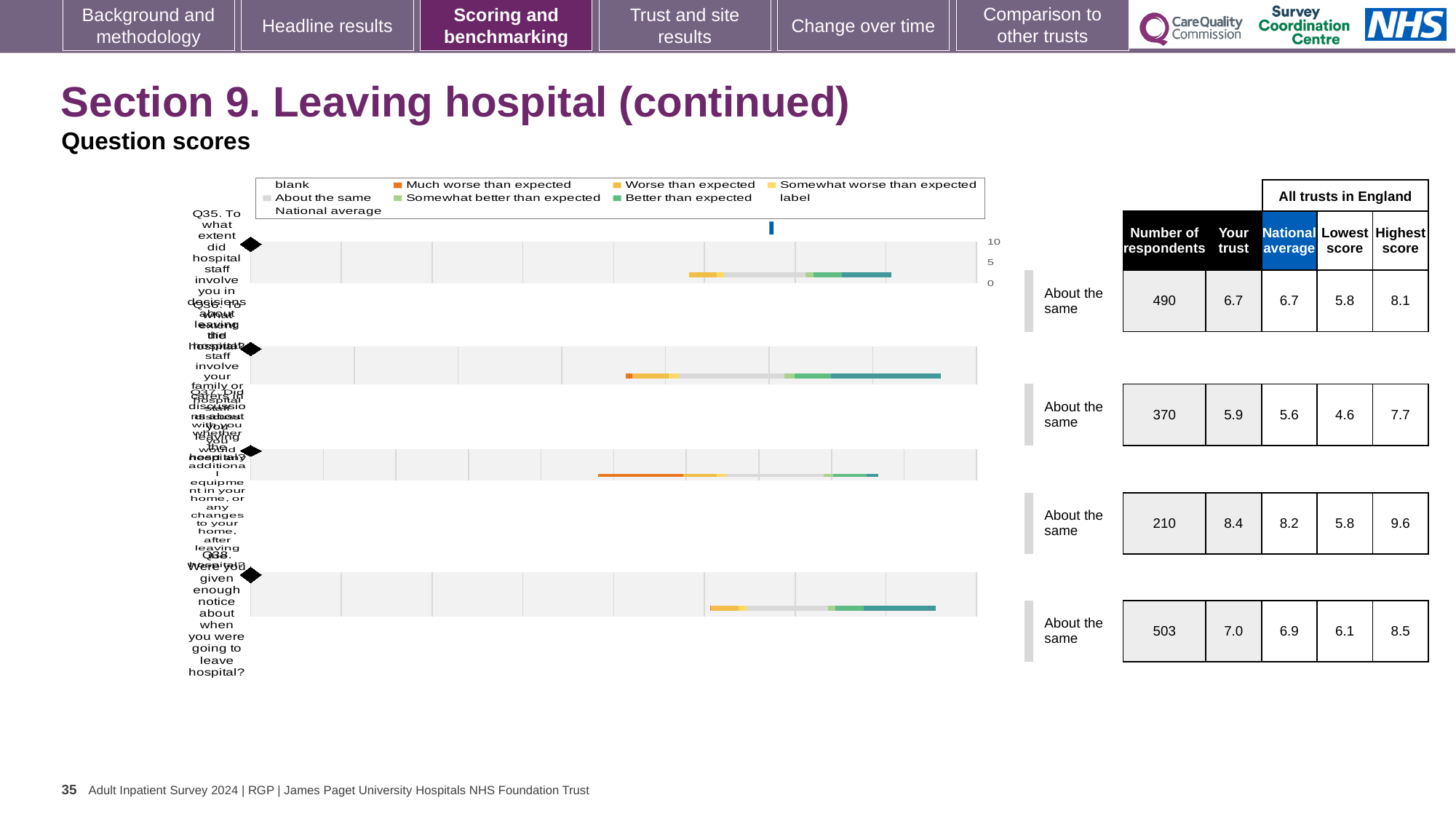
What benchmark category is shown for Q35? About the same What is the 'Your trust' score for Q38 (given enough notice about leaving hospital)? 7.0 What is the 'Your trust' score for Q35 (involving you in decisions about leaving hospital)? 6.7 What type of chart is used to show the question scores? Bar chart What is the highest score across all trusts in England for Q38? 8.5 Which has the higher 'Your trust' score, Q35 or Q38? Q38 What is the lowest score across all trusts in England for Q38? 6.1 What is the national average score for Q35? 6.7 By how much does the trust's score for Q38 exceed the national average for Q38? 0.1 What is the difference between the highest and lowest scores for Q38? 2.4 How many respondents answered Q35? 490 How many questions are plotted on the chart? 4